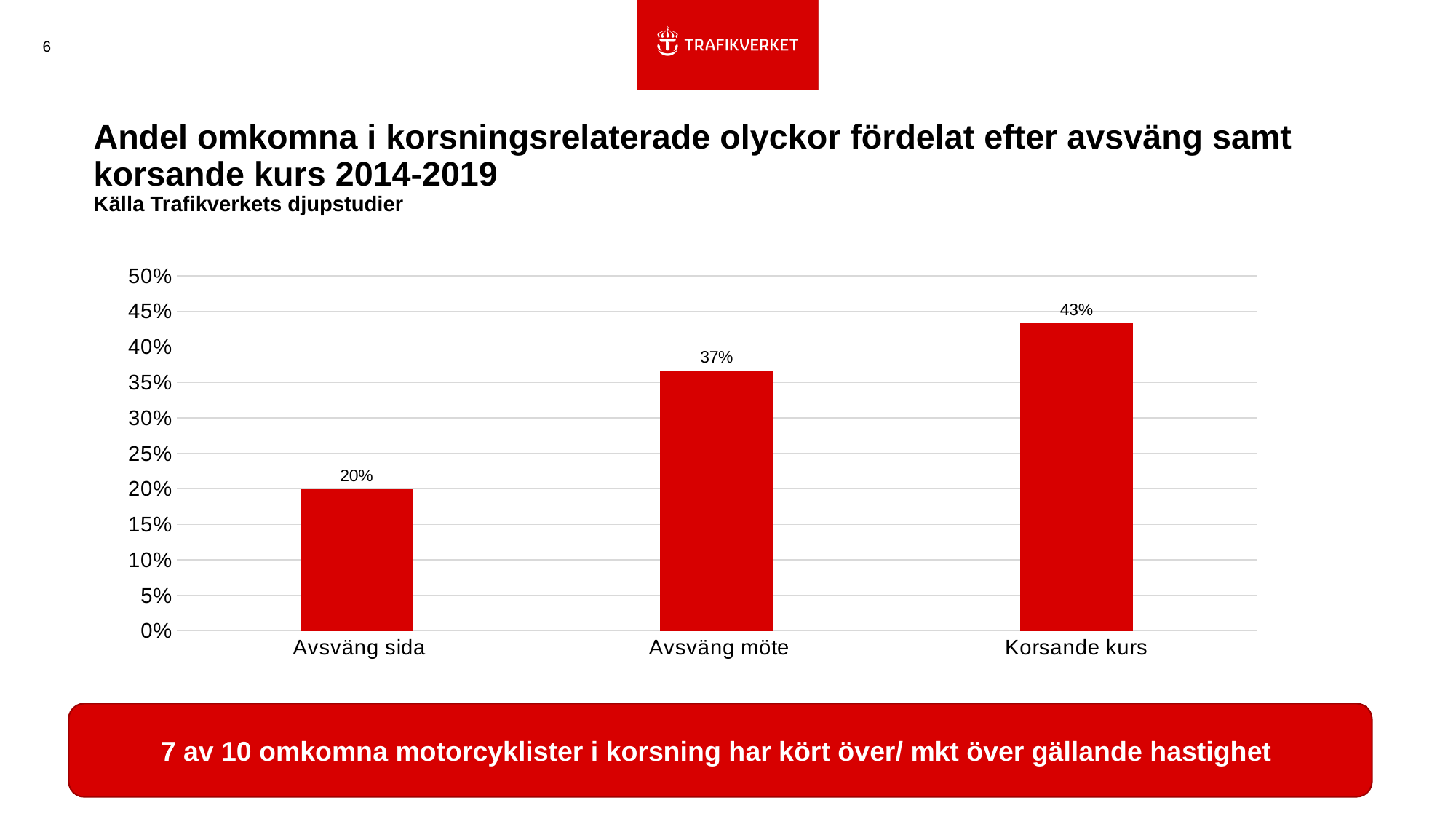
What is the difference between the values for Korsande kurs and Avsväng sida? 23% What is the value for Korsande kurs? 43% Is the value for Avsväng möte greater or less than 30%? greater Which category has the highest value? Korsande kurs Which category has the lowest value? Avsväng sida What kind of chart is shown on the slide? bar chart What is the value for Avsväng sida? 20% Which is larger, the value for Avsväng möte or the value for Korsande kurs? Korsande kurs Do the values rise or fall from left to right along the x axis? rise What is the difference between the values for Avsväng möte and Avsväng sida? 17% What is the value for Avsväng möte? 37% How many categories are shown on the x axis? 3